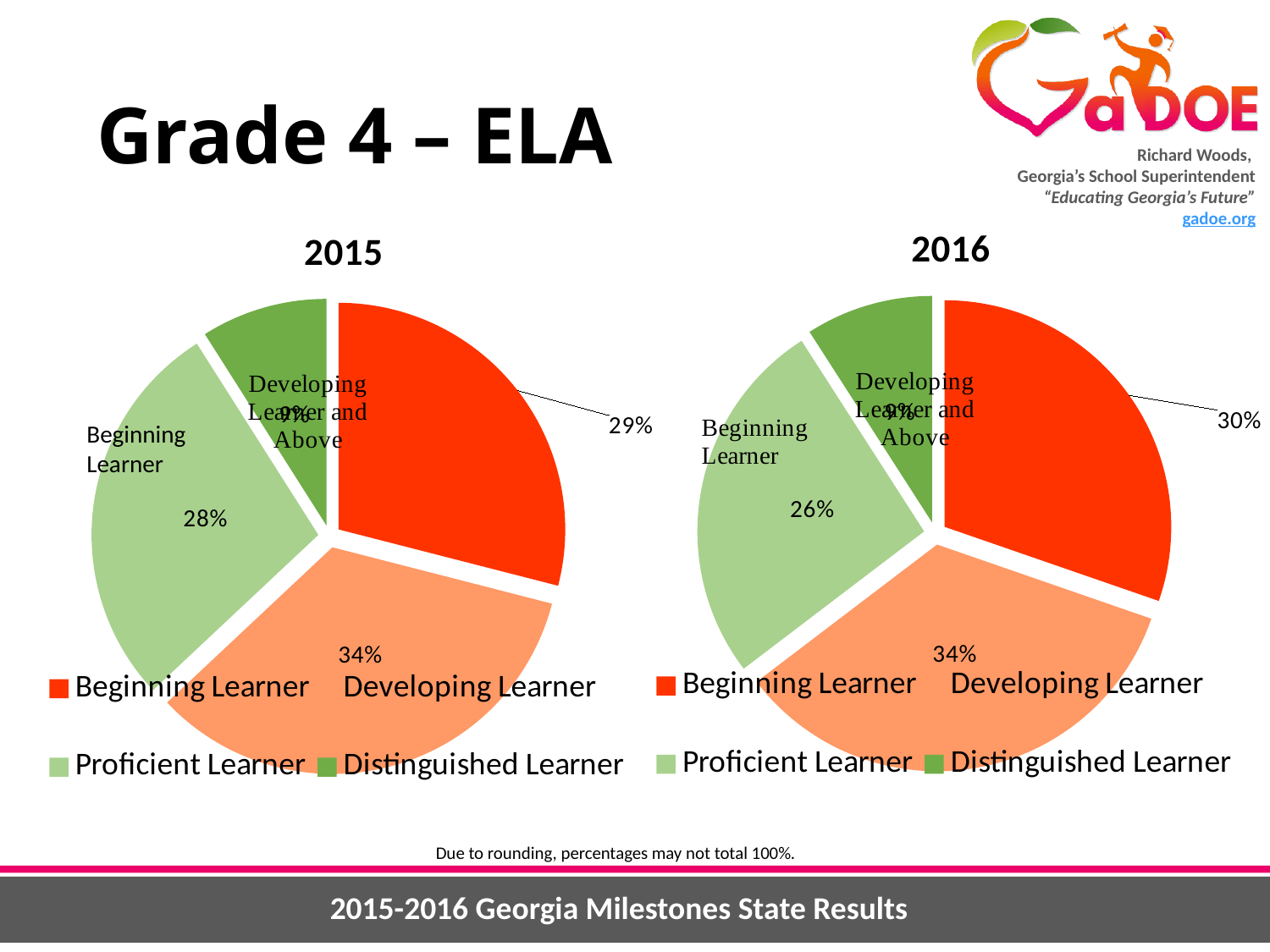
In the 2016 pie chart, what percentage of students were Developing Learners? 34% In the 2015 pie chart, what percentage of students were Proficient Learners? 28% Comparing the 2015 and 2016 pie charts, which year had a larger share of Proficient Learners? 2015 In the 2015 pie chart, which achievement level has the largest share? Developing Learner In the 2015 pie chart, what percentage of students were Beginning Learners? 29% In the 2016 pie chart, what percentage of students were Proficient Learners? 26% What is the difference between the Proficient Learner share in 2015 and in 2016? 2% In the 2016 pie chart, which achievement level has the smallest share? Distinguished Learner In the 2015 pie chart, how much larger is the Developing Learner share than the Beginning Learner share? 5% What type of chart is used to show the 2015 and 2016 results? Pie chart In the 2016 pie chart, what percentage of students were Beginning Learners? 30% How many achievement levels does the legend of the 2016 chart list? 4